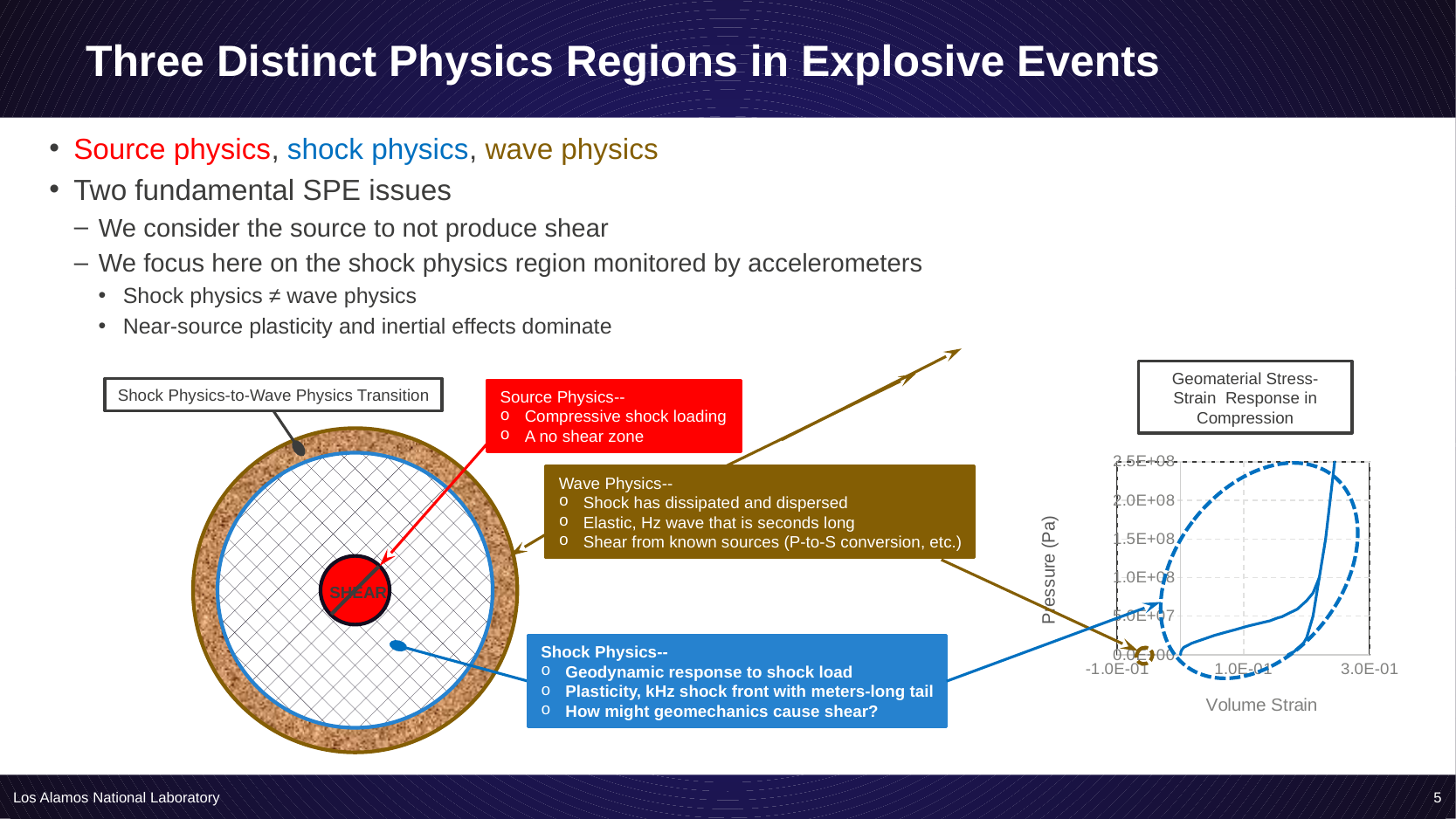
On the Geomaterial Stress-Strain Response in Compression chart, is the pressure at a volume strain of 1.0E-01 greater or less than 1.0E+08? less How many labelled tick values are shown on the x axis of the Geomaterial Stress-Strain Response in Compression chart? 3 On the Geomaterial Stress-Strain Response in Compression chart, does pressure generally rise or fall as volume strain increases along the x axis? rise What is the label of the y axis on the Geomaterial Stress-Strain Response in Compression chart? Pressure (Pa) What is the highest tick value shown on the y axis of the Geomaterial Stress-Strain Response in Compression chart? 2.5E+08 What is the lowest tick value shown on the x axis of the Geomaterial Stress-Strain Response in Compression chart? -1.0E-01 What kind of chart is the Geomaterial Stress-Strain Response in Compression chart? line chart On the Geomaterial Stress-Strain Response in Compression chart, is the highest pressure reached by the curve greater or less than 2.0E+08? greater What is the title of the chart on the right side of the slide? Geomaterial Stress-Strain Response in Compression